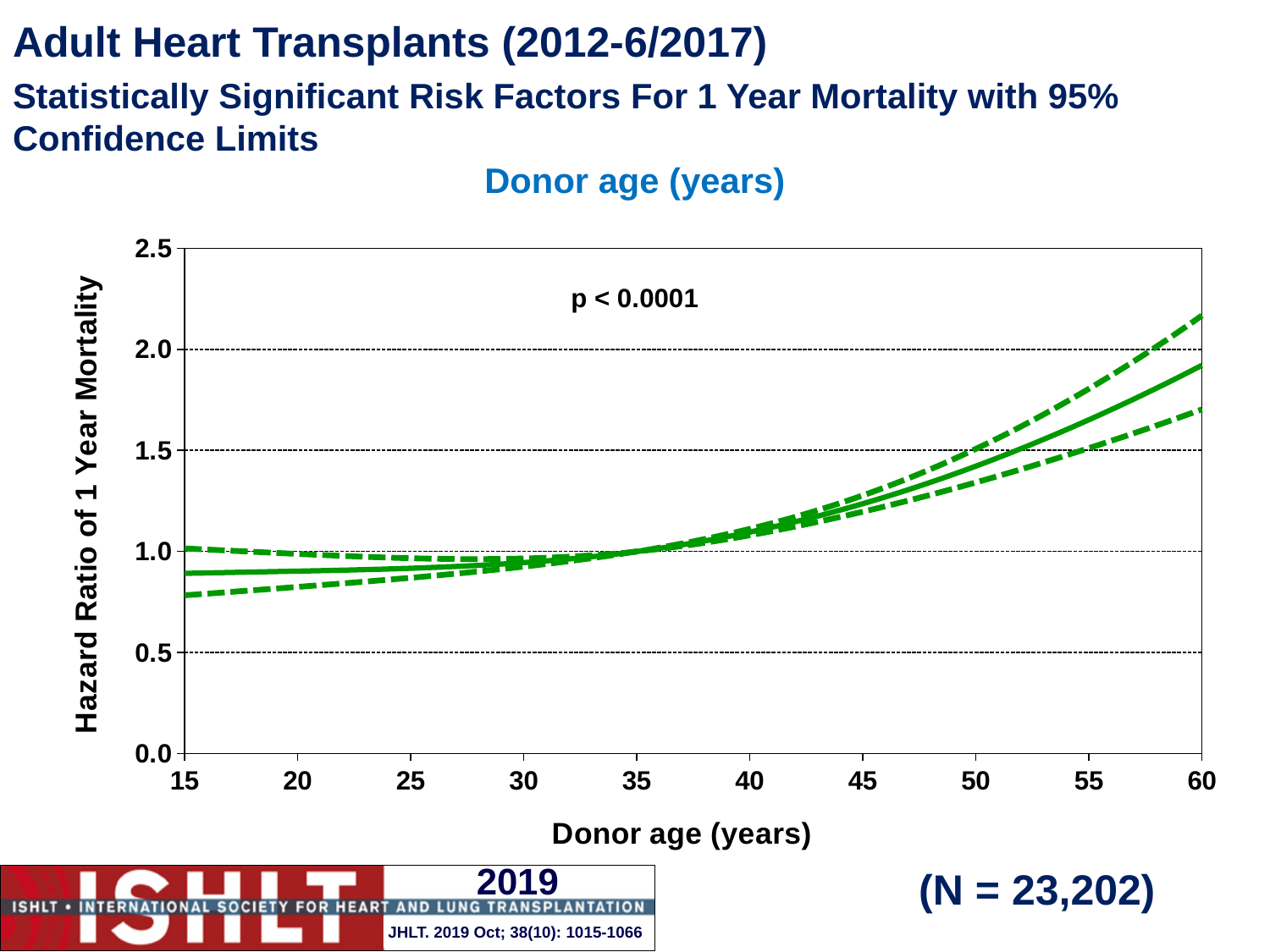
What is the sample size N shown on the slide? N = 23,202 Is the upper dashed confidence limit at donor age 60 greater or less than 2.0? greater Is the hazard ratio on the solid line at donor age 15 greater or less than 1.0? less Is the hazard ratio on the solid line at donor age 40 greater or less than 1.0? greater Is the hazard ratio on the solid line higher at donor age 60 or at donor age 15? 60 What kind of chart is shown on the slide? line chart What p-value is printed on the chart? p < 0.0001 How many lines are plotted on the chart? 3 Does the hazard ratio of 1 year mortality rise or fall as donor age increases from 15 to 60 years? rise